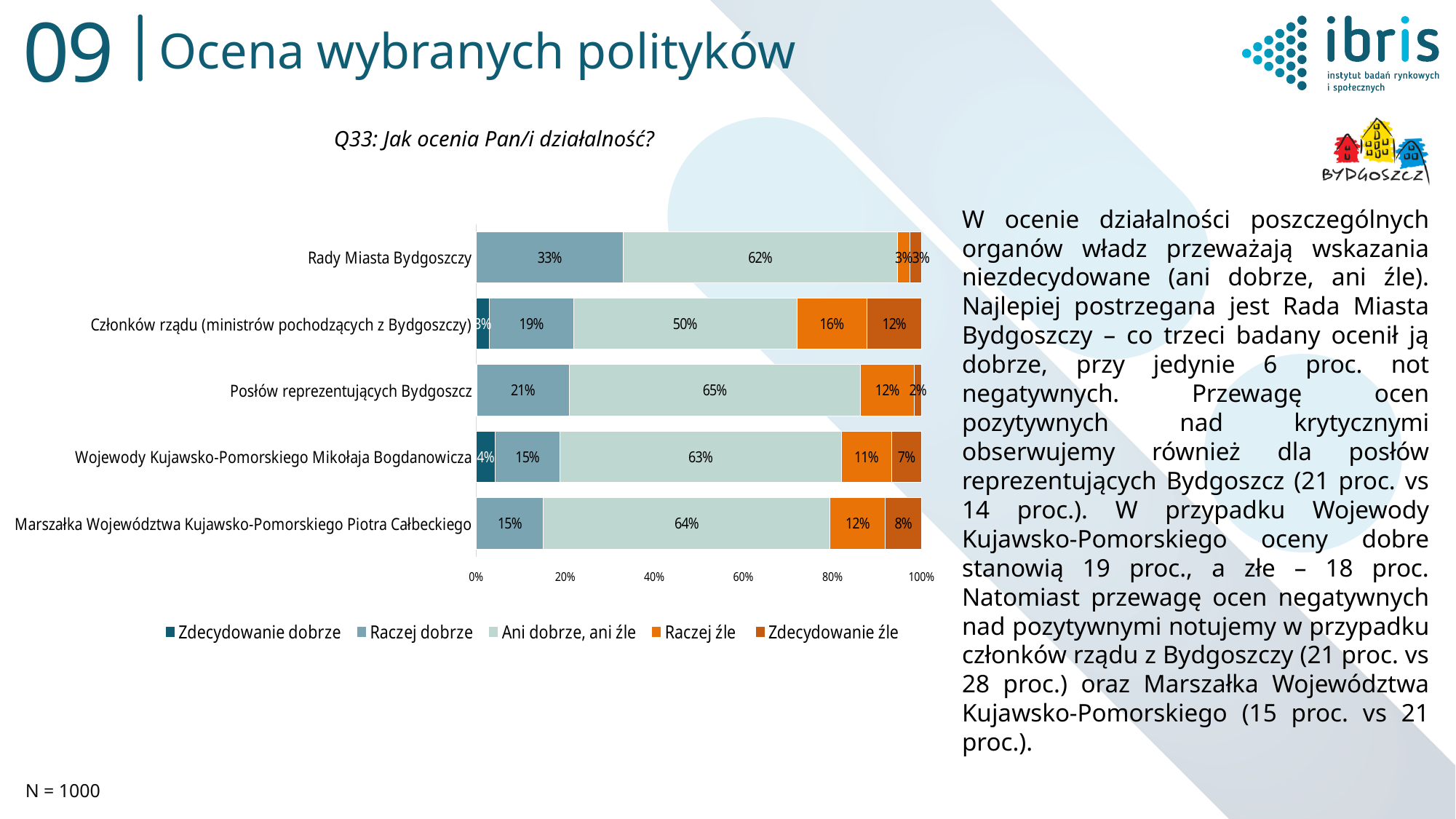
What question text is shown above the chart? Q33: Jak ocenia Pan/i działalność? What is the difference between the 'Raczej dobrze' values for Rady Miasta Bydgoszczy and Marszałka Województwa Kujawsko-Pomorskiego Piotra Całbeckiego? 18% How many series does the legend list? 5 What is the 'Raczej źle' value for Członków rządu (ministrów pochodzących z Bydgoszczy)? 16% Which category has the highest 'Raczej dobrze' value? Rady Miasta Bydgoszczy Which category has the lowest 'Ani dobrze, ani źle' value? Członków rządu (ministrów pochodzących z Bydgoszczy) Which is larger: the 'Zdecydowanie źle' value for Członków rządu or for Marszałka Województwa Kujawsko-Pomorskiego Piotra Całbeckiego? Członków rządu What is the 'Ani dobrze, ani źle' value for Rady Miasta Bydgoszczy? 62% What is the 'Raczej dobrze' value for Posłów reprezentujących Bydgoszcz? 21% How many categories (politicians/bodies) are shown in the chart? 5 What kind of chart is shown on the slide? stacked bar chart What is the 'Zdecydowanie źle' value for Wojewody Kujawsko-Pomorskiego Mikołaja Bogdanowicza? 7%